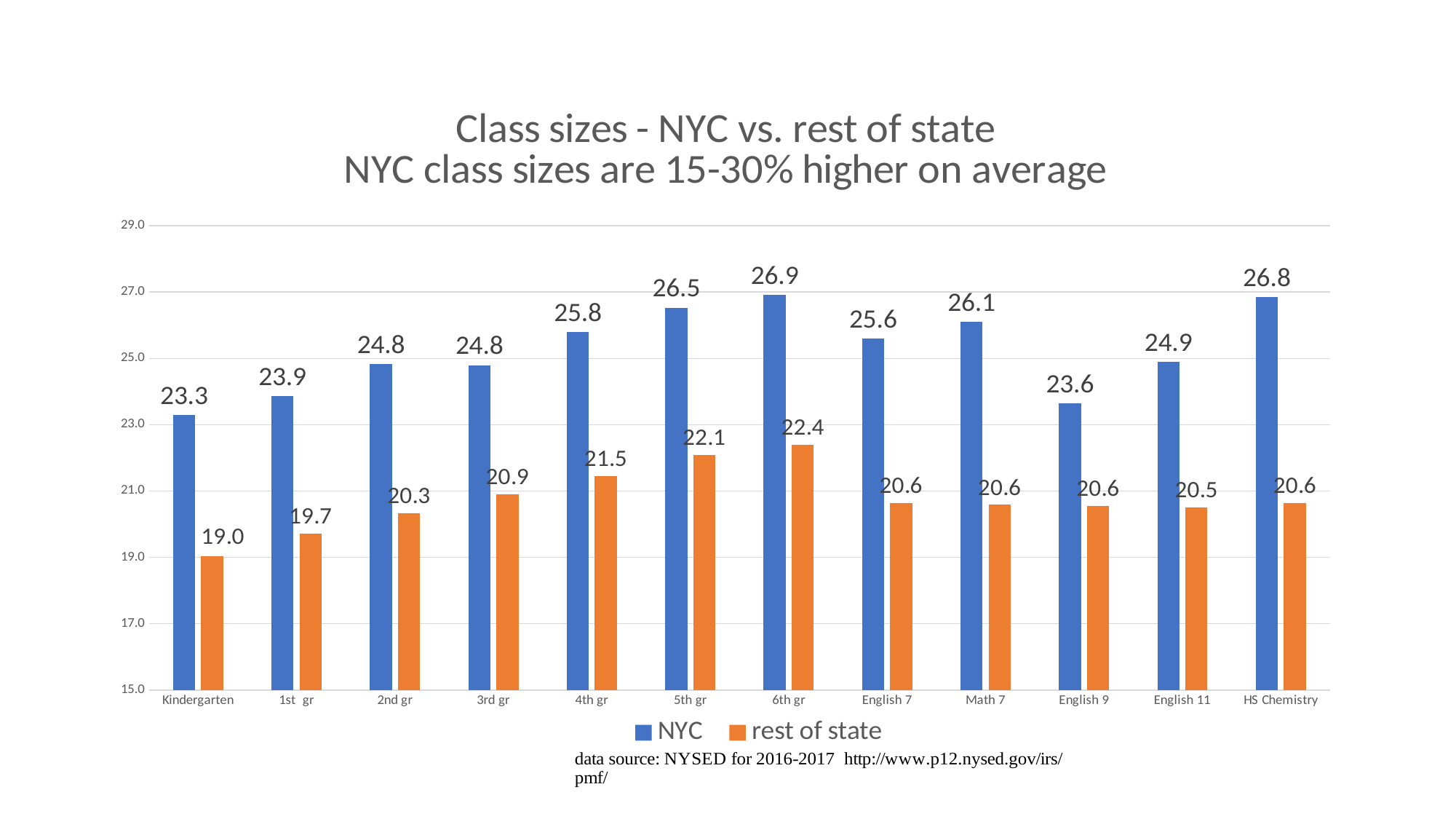
What is the difference between the NYC and rest of state class sizes for 5th gr? 4.4 What is the NYC class size for Kindergarten? 23.3 Is the rest of state value for 4th gr greater or less than 21.0? greater Which colour represents the rest of state series? orange What kind of chart is shown on the slide? bar chart Which category has the lowest rest of state class size? Kindergarten What is the rest of state class size for 6th gr? 22.4 Which category has the highest NYC class size? 6th gr Which is larger, the NYC class size for Math 7 or for English 9? Math 7 How many series does the legend list? 2 How many categories are shown on the x axis? 12 What is the NYC class size for HS Chemistry? 26.8